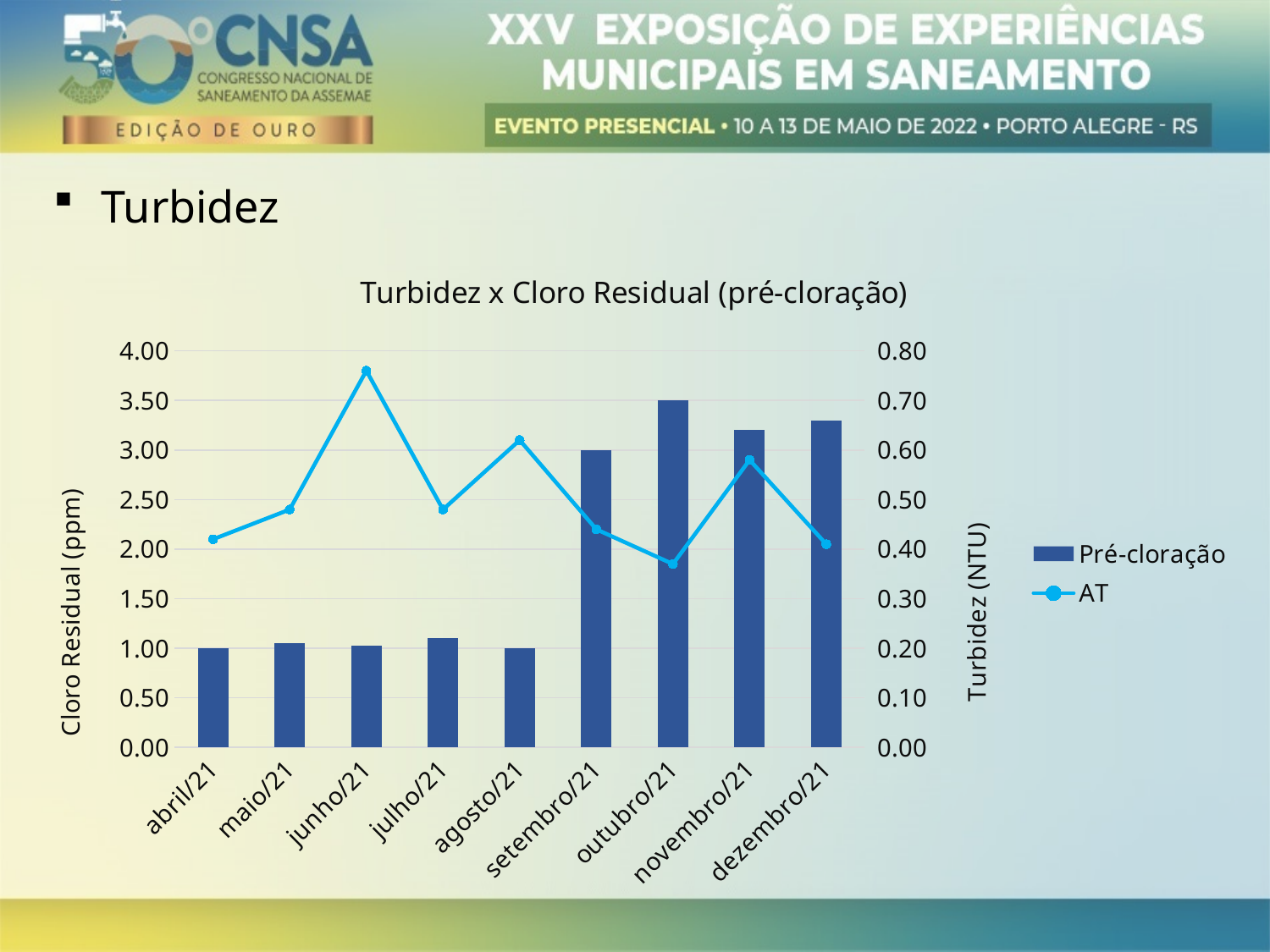
Which month has the lowest AT (Turbidez) value? outubro/21 How many months are shown on the x axis? 9 What is the title of the chart? Turbidez x Cloro Residual (pré-cloração) Which month has the highest Pré-cloração bar? outubro/21 What is the label of the right-hand vertical axis? Turbidez (NTU) Is the Pré-cloração value for julho/21 greater or less than 1.50 ppm? less Which is larger, the Pré-cloração bar for outubro/21 or for dezembro/21? outubro/21 Which month has the highest AT (Turbidez) value? junho/21 How many series does the legend list? 2 What kind of chart is shown on the slide? Combined bar and line chart Is the Pré-cloração value for setembro/21 greater or less than 2.00 ppm? greater Is the AT value for junho/21 greater or less than 0.70 NTU? greater